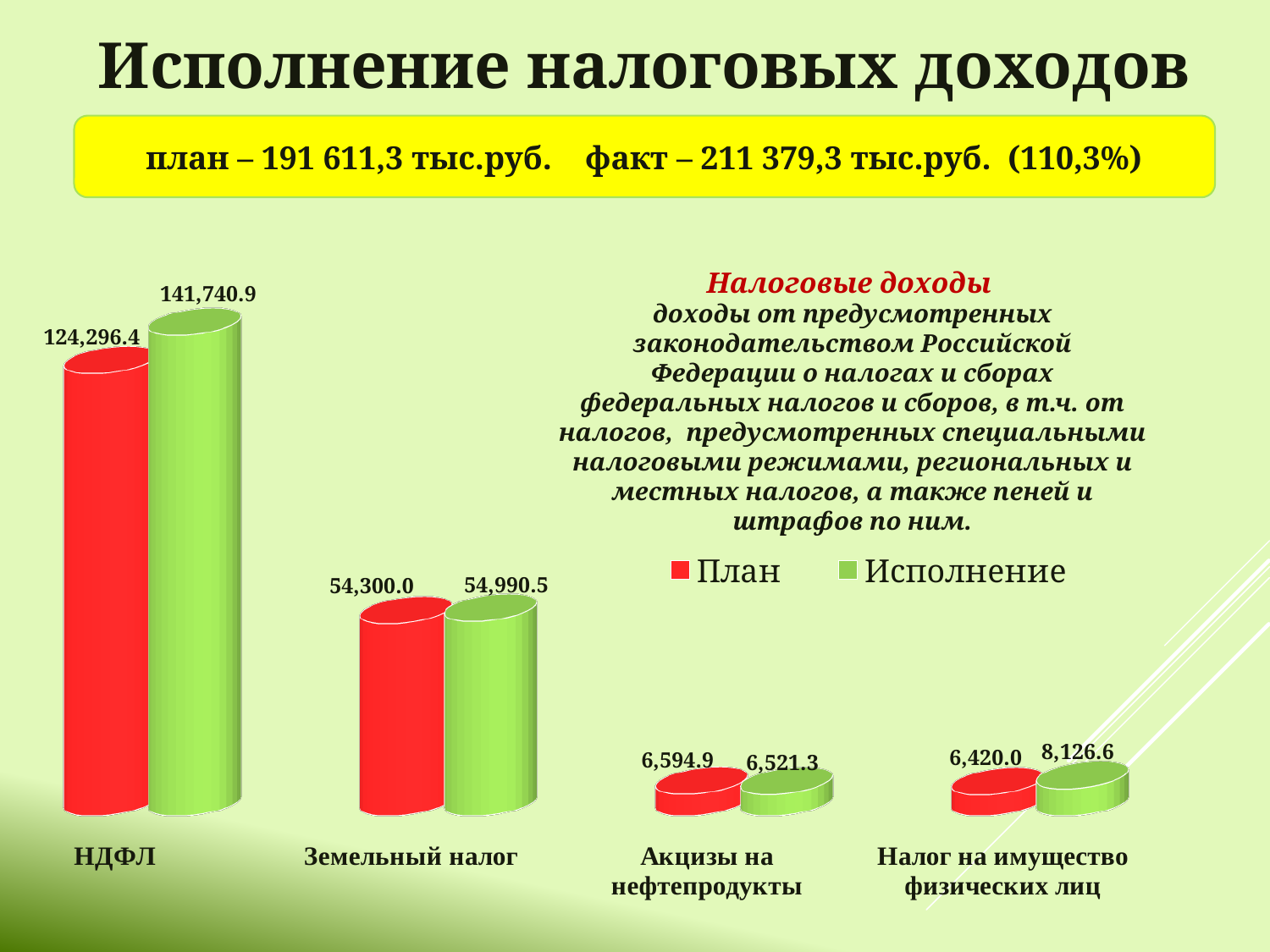
What is the difference between the Исполнение and План values for НДФЛ? 17,444.5 What is the difference between the Исполнение and План values for Налог на имущество физических лиц? 1,706.6 Which category has the highest Исполнение value? НДФЛ How many series does the chart legend list? 2 What is the План value for Акцизы на нефтепродукты? 6,594.9 What is the Исполнение value for Налог на имущество физических лиц? 8,126.6 What is the Исполнение value for Земельный налог? 54,990.5 For Акцизы на нефтепродукты, which is larger: План or Исполнение? План What kind of chart is shown on the slide? Bar chart What is the План value for НДФЛ? 124,296.4 Which category has the lowest План value? Налог на имущество физических лиц How many categories are shown on the x axis of the chart? 4